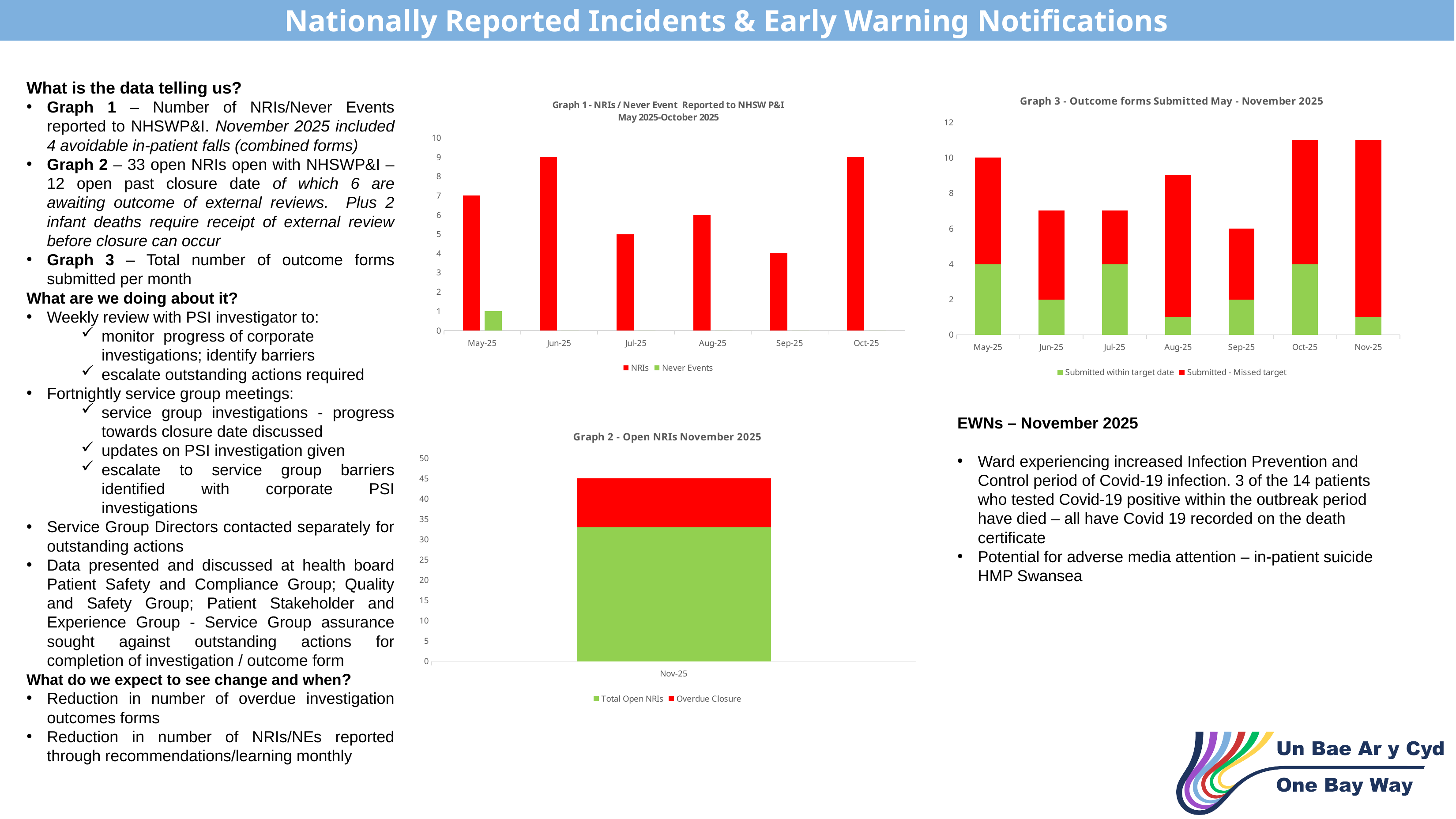
In Graph 2, is the value for Total Open NRIs greater or less than 30? greater What type of chart is Graph 3? Stacked bar chart In Graph 3, what is the total number of outcome forms submitted in May-25? 10 In Graph 1, which month has the lowest number of NRIs? Sep-25 In Graph 2, what is the total height of the stacked bar for Nov-25? 45 In Graph 3, which month has the lowest total number of outcome forms submitted? Sep-25 In Graph 1, how many months are shown on the x axis? 6 In Graph 1, how many Never Events were reported in May-25? 1 In Graph 1, how many series does the legend list? 2 In Graph 1, how many NRIs were reported in Sep-25? 4 In Graph 1, what is the difference between the NRIs reported in May-25 and Jul-25? 2 In Graph 1, how many NRIs were reported in Jun-25? 9